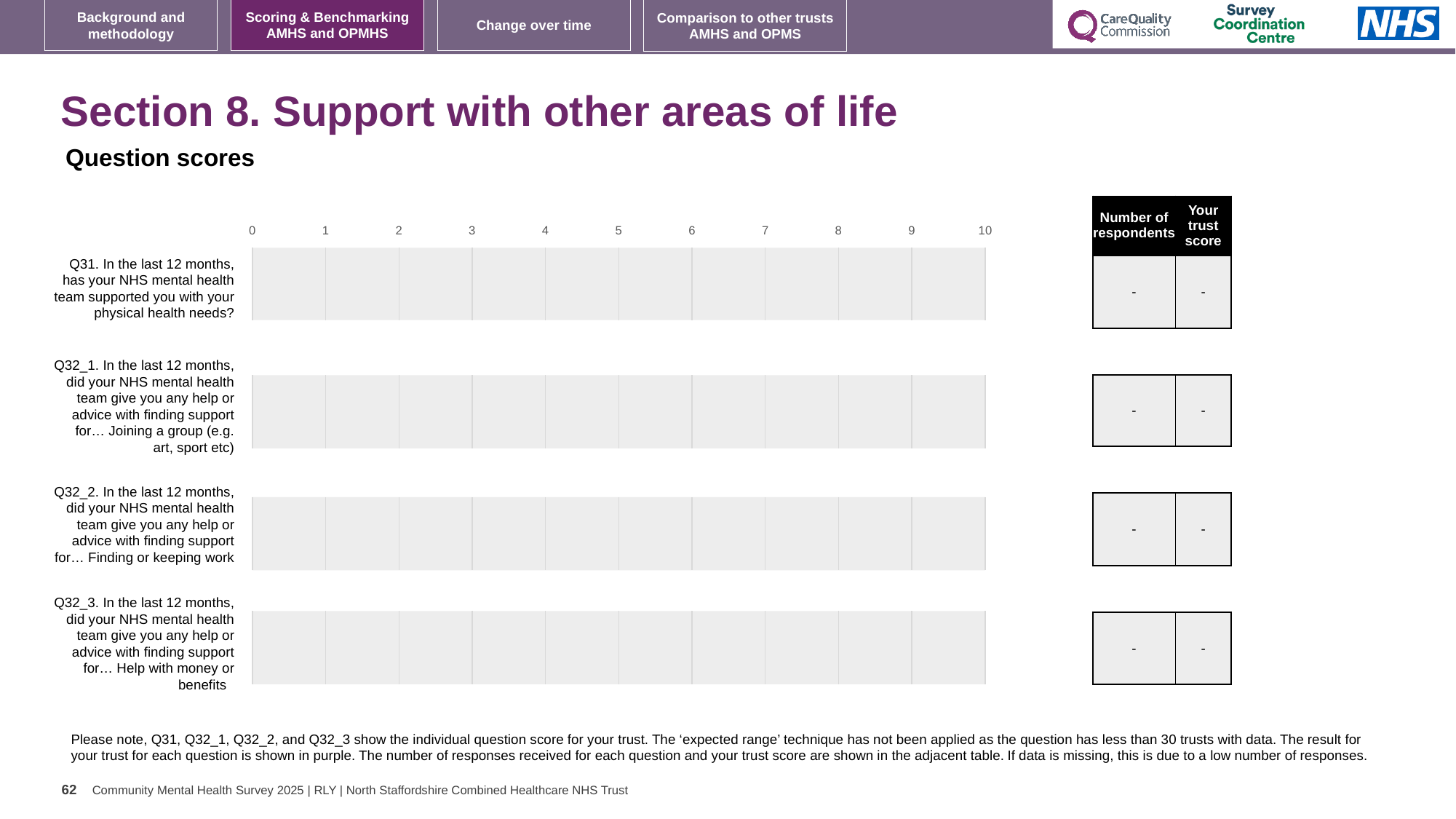
How many questions (categories) are listed on the chart? 4 Which question label appears last (at the bottom) of the chart? Q32_3 What is the 'Your trust score' shown in the table for Q31? - What is the 'Your trust score' shown in the table for Q32_3? - Which question label appears first (at the top) of the chart? Q31 What is the 'Number of respondents' shown in the table for Q32_1? - What is the highest value shown on the chart's horizontal axis? 10 What is the 'Number of respondents' shown in the table for Q32_2? -